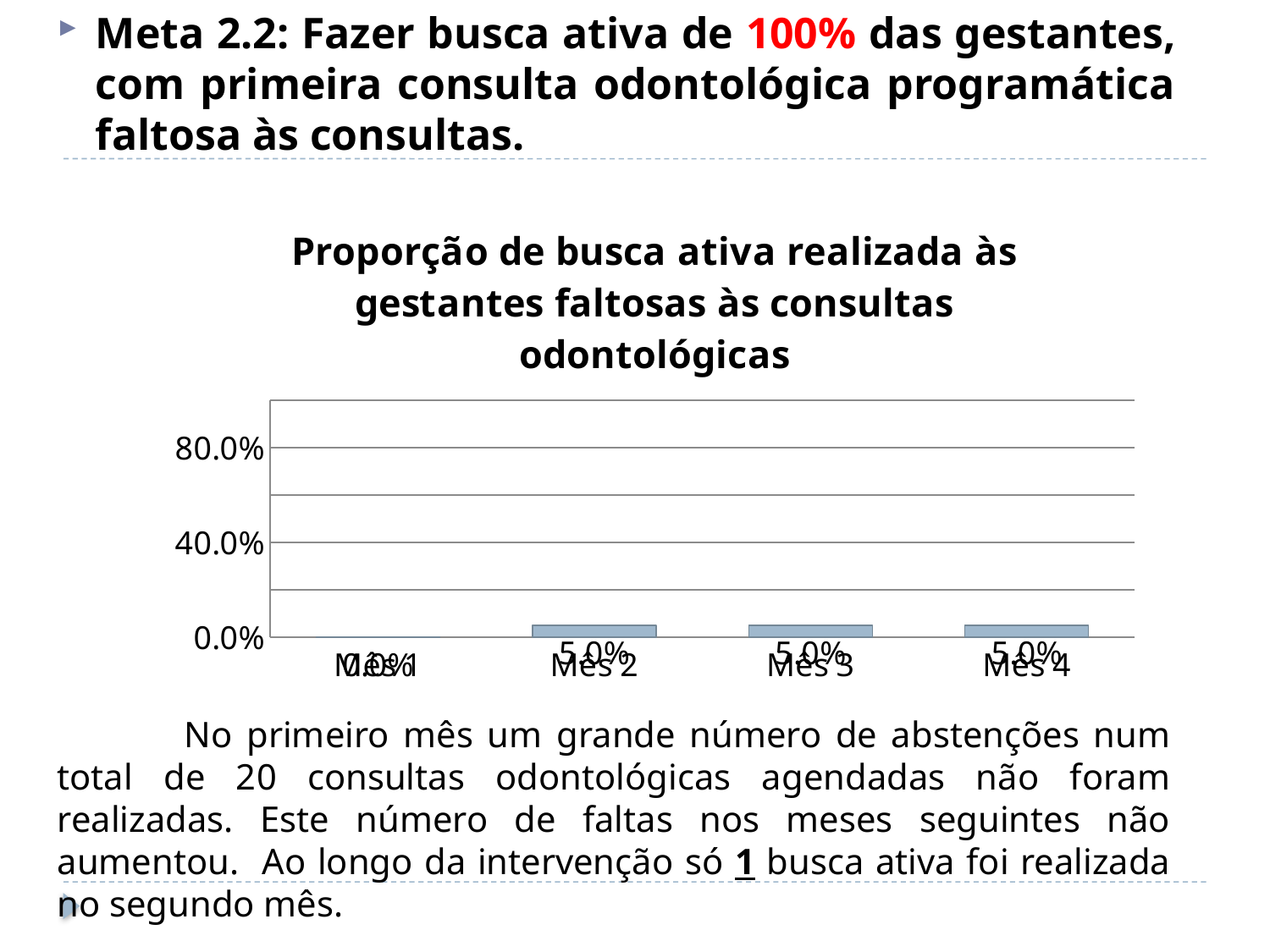
What is the value for Mês 2? 5.0% Is the value for Mês 3 greater or less than 40.0%? less How many months (categories) are plotted in the chart? 4 Which is larger, the value for Mês 1 or the value for Mês 3? Mês 3 What is the value for Mês 4? 5.0% What is the difference between the value for Mês 2 and the value for Mês 1? 5.0% Which month has the lowest value? Mês 1 What is the title of the chart? Proporção de busca ativa realizada às gestantes faltosas às consultas odontológicas What is the highest tick label shown on the vertical axis? 80.0% What type of chart is shown on the slide? bar chart What is the value for Mês 1? 0.0% Does the value rise or fall from Mês 1 to Mês 2? rise